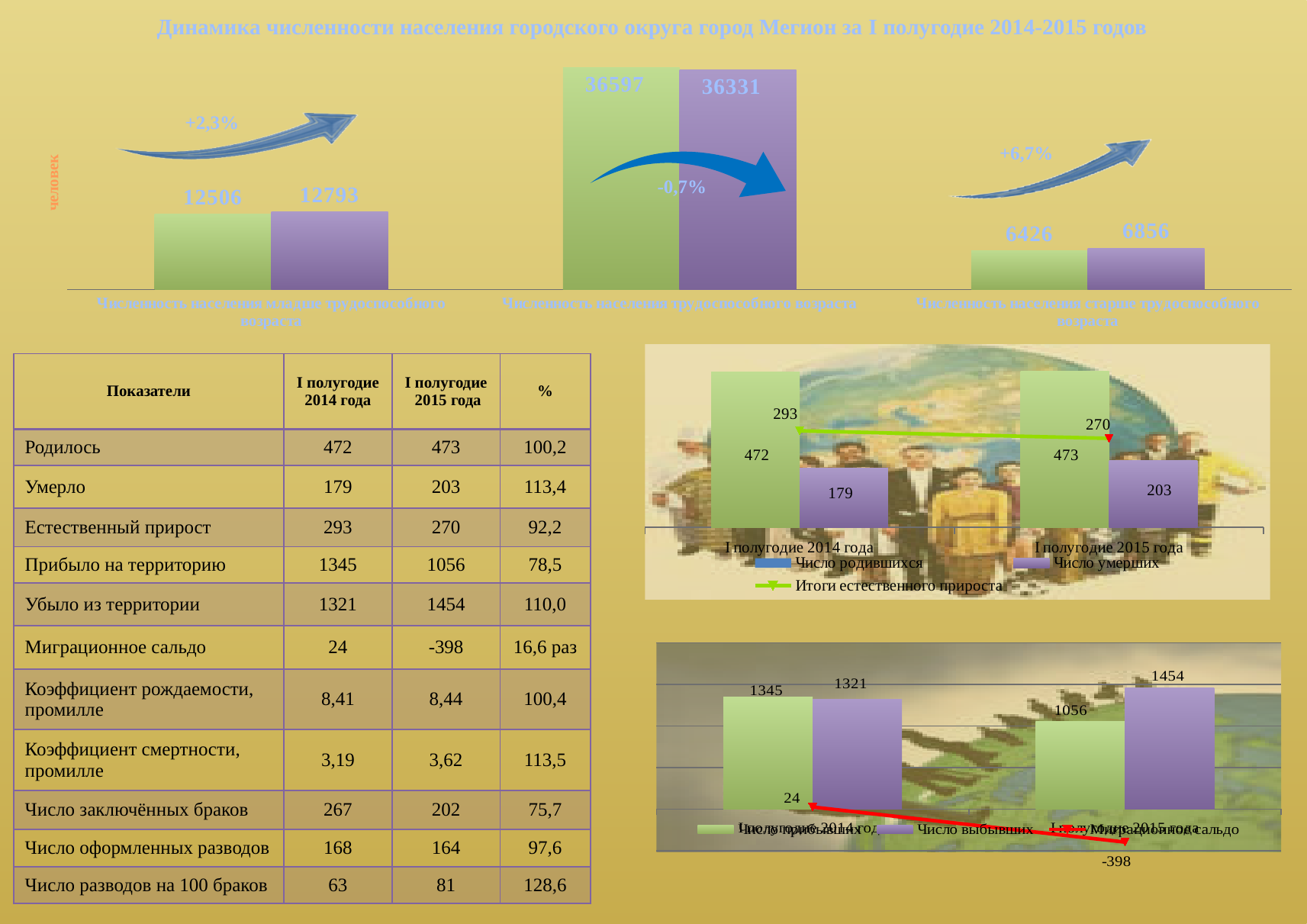
In the middle-right chart (births and deaths), what is the value of Число умерших for I полугодие 2015 года? 203 In the top chart, what is the value of the green (2014) bar for the working-age population (трудоспособного возраста)? 36597 In the top chart, what is the difference between the 2015 and 2014 values for the population younger than working age (12793 and 12506)? 287 In the bottom-right chart (migration), what is the value of Число выбывших for I полугодие 2015 года? 1454 In the top chart, what percentage change is shown above the bars for the population younger than working age (младше трудоспособного возраста)? +2,3% In the middle-right chart (births and deaths), how many series does the legend list? 3 In the top chart, what is the value of the purple (2015) bar for the population older than working age (старше трудоспособного возраста)? 6856 In the bottom-right chart (migration), does the Миграционное сальдо line rise or fall from I полугодие 2014 года to I полугодие 2015 года? fall In the top chart, how many categories are shown on the x axis? 3 In the bottom-right chart (migration), which is larger for I полугодие 2014 года: Число прибывших or Число выбывших? Число прибывших In the top chart, which age group has the highest population values? Численность населения трудоспособного возраста In the middle-right chart (births and deaths), what is the value of Итоги естественного прироста for I полугодие 2014 года? 293